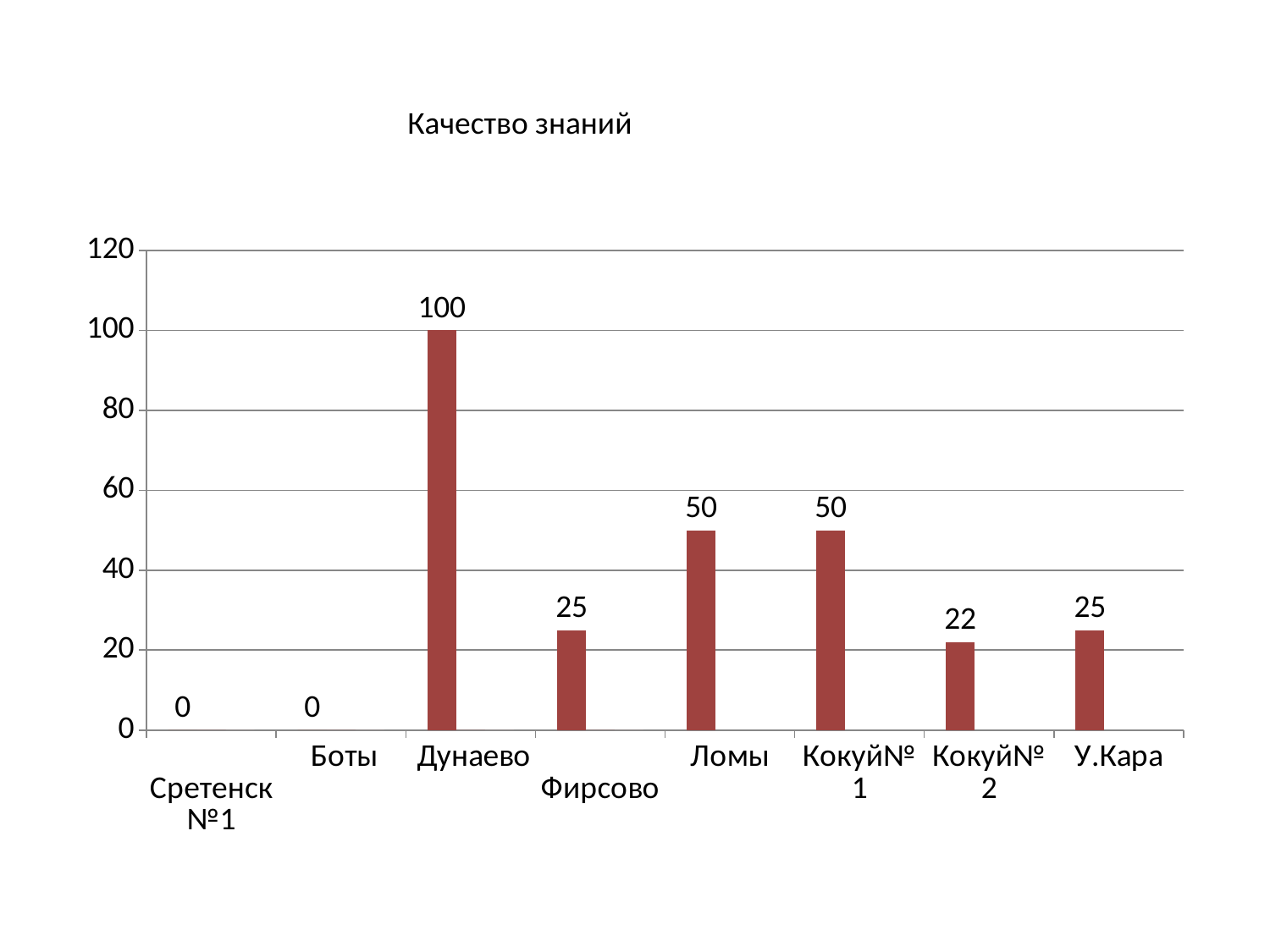
Which is larger, the value for Ломы or the value for Фирсово? Ломы What is the value for Фирсово? 25 What is the value for Кокуй№2? 22 What is the title of the chart? Качество знаний Which category has the highest value? Дунаево What is the value for Дунаево? 100 How many categories are shown on the x axis? 8 What kind of chart is this? bar chart How many categories have a value of 0? 2 Is the value for Кокуй№1 greater or less than 40? greater What is the difference between the values for У.Кара and Кокуй№2? 3 What is the difference between the values for Дунаево and Ломы? 50